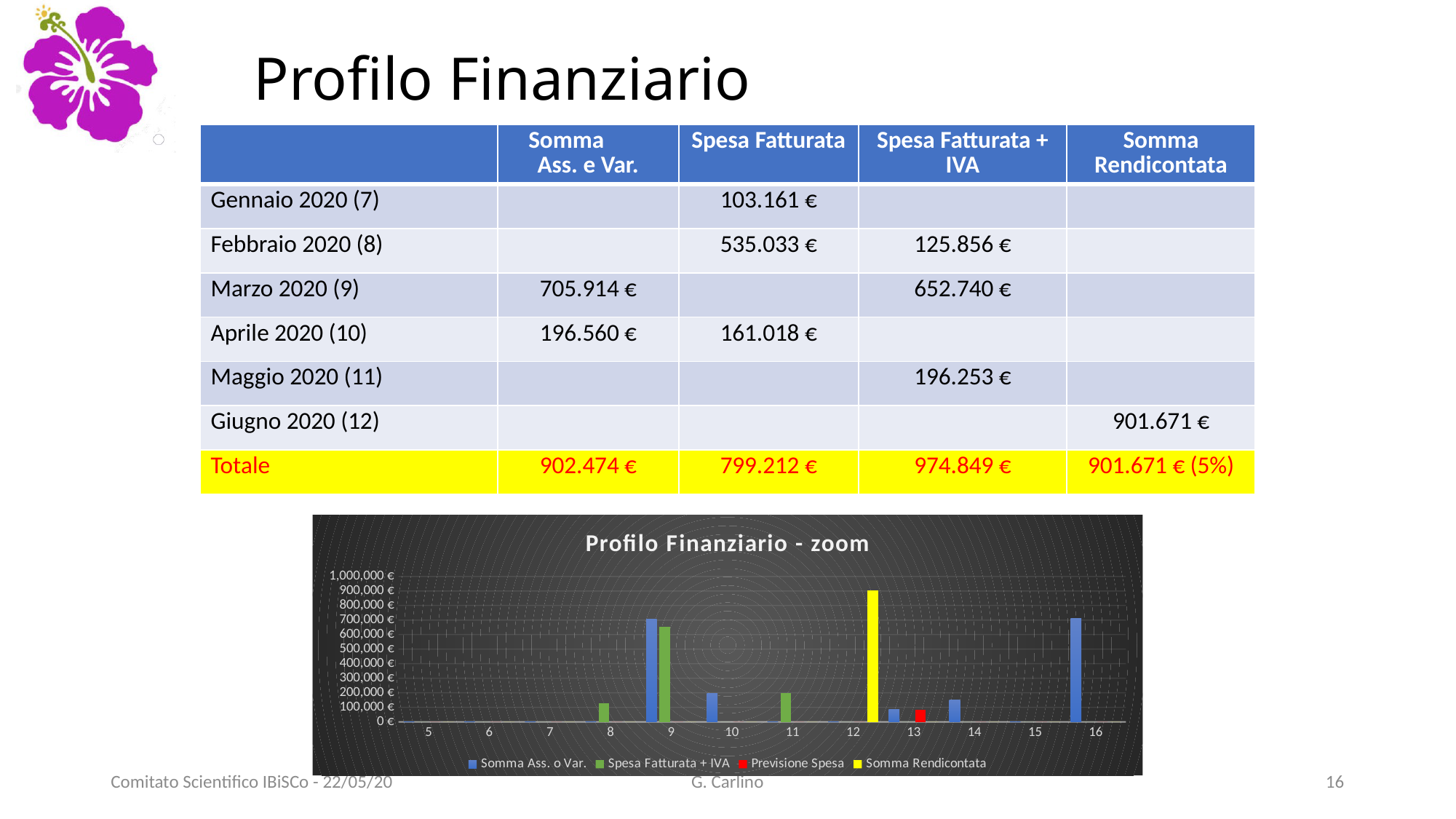
Is the Somma Ass. o Var. bar at category 9 greater or less than 600,000 €? greater Is the Somma Ass. o Var. bar at category 16 greater or less than 500,000 €? greater How many series does the chart legend list? 4 What colour represents the Previsione Spesa series in the chart legend? red Is the Spesa Fatturata + IVA bar at category 8 greater or less than 200,000 €? less What is the title of the chart on the slide? Profilo Finanziario - zoom What kind of chart is shown on the slide? bar chart Which is taller: the Somma Rendicontata bar at category 12 or the Somma Ass. o Var. bar at category 9? Somma Rendicontata bar at category 12 Which series has the tallest bar in the chart? Somma Rendicontata At category 9, which bar is taller: Somma Ass. o Var. or Spesa Fatturata + IVA? Somma Ass. o Var. How many categories are labelled along the x axis of the chart? 12